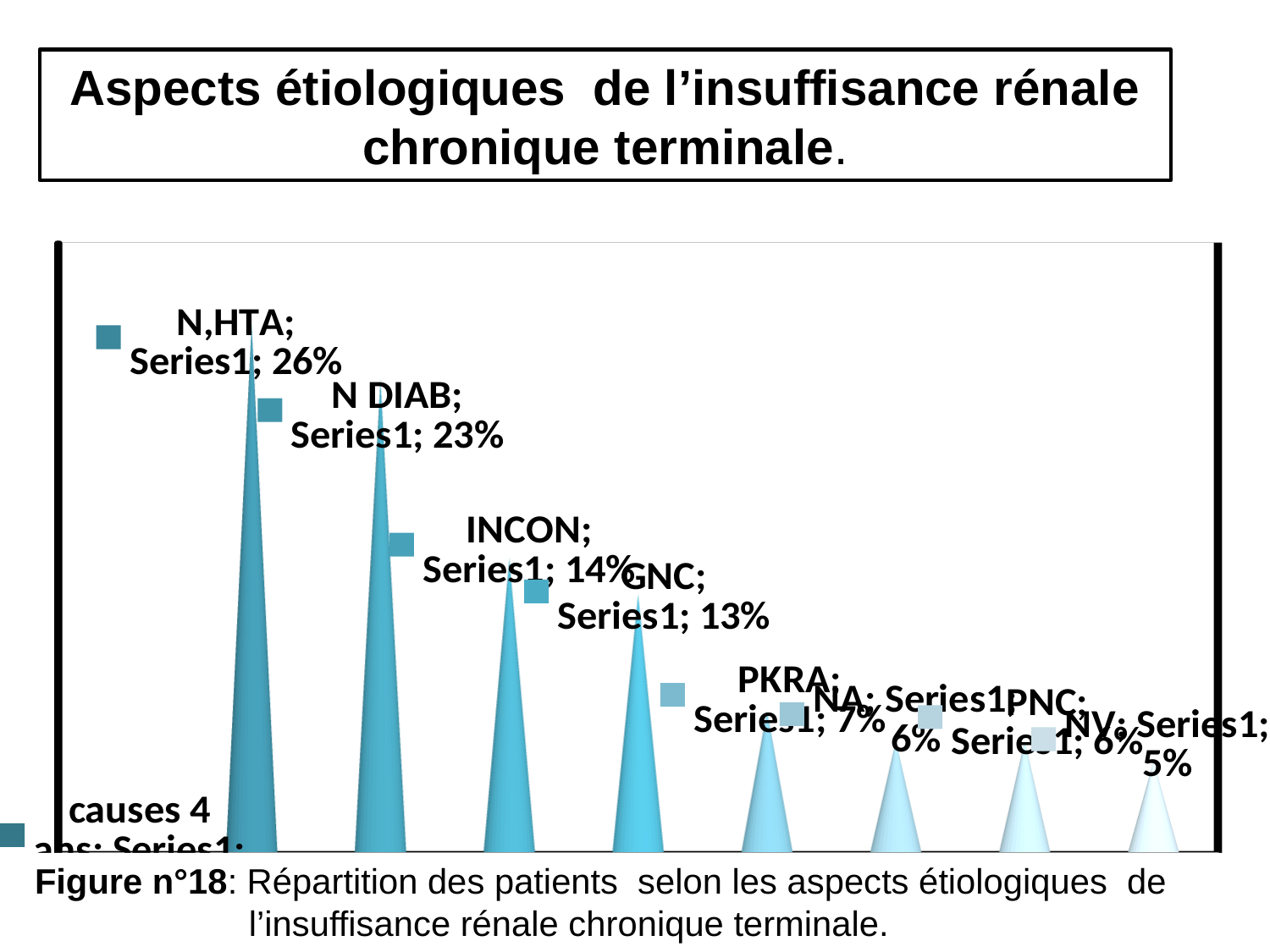
What is the value for NV? 5% What is the value for N,HTA? 26% Which is larger, the value for INCON or the value for GNC? INCON What is the value for PKRA? 7% What is the value for INCON? 14% Which category has the highest value? N,HTA What is the value for GNC? 13% Which is larger, the value for N DIAB or the value for NV? N DIAB What is the value for N DIAB? 23% What is the difference between the values for N,HTA and N DIAB? 3% What is the difference between the values for INCON and PKRA? 7% What kind of chart is shown on the slide? bar chart